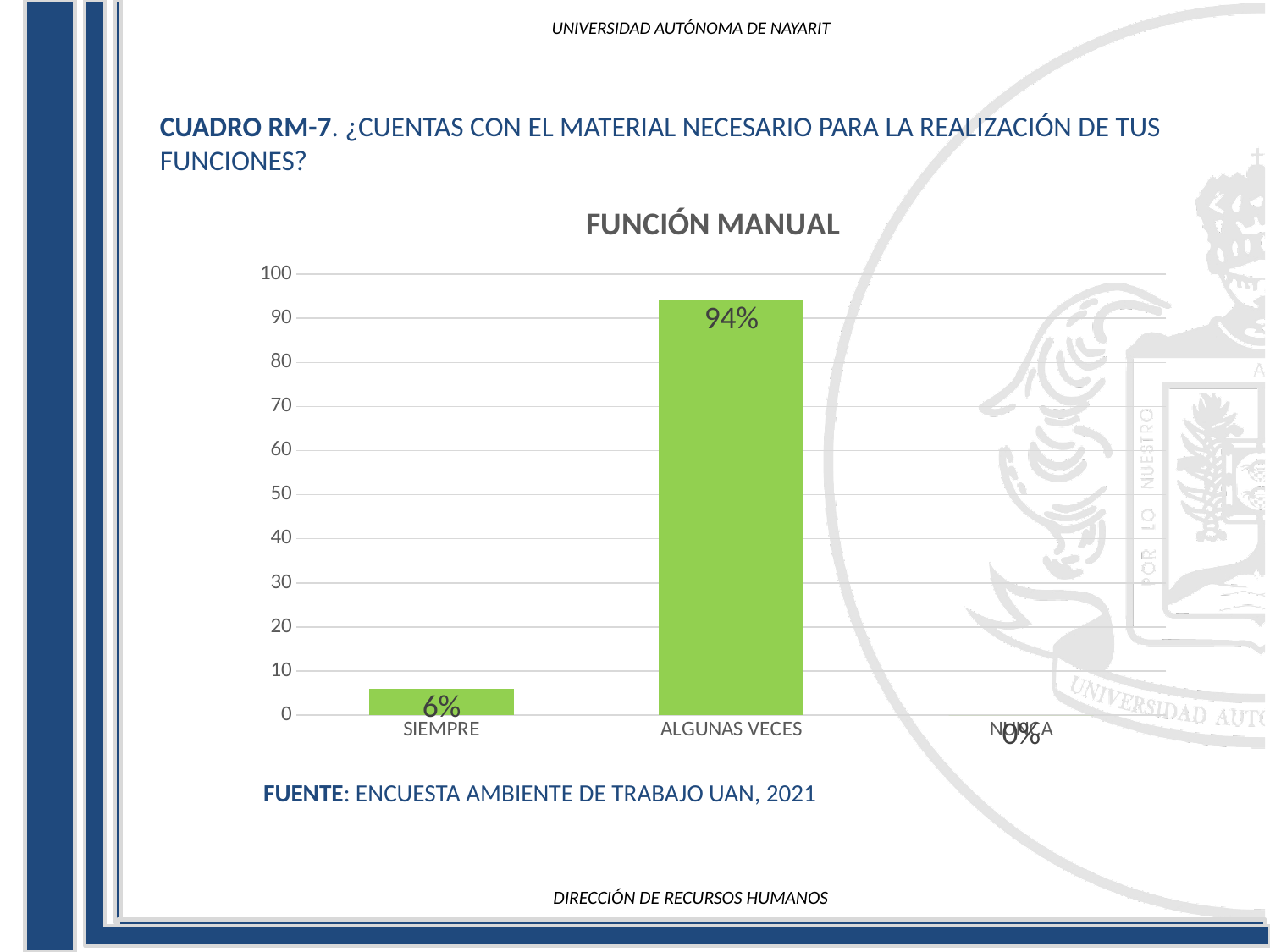
Which category has the lowest value? NUNCA What is the value for SIEMPRE? 6% What is the value for NUNCA? 0% Which is larger, the value for SIEMPRE or the value for ALGUNAS VECES? ALGUNAS VECES What is the value for ALGUNAS VECES? 94% Is the value for SIEMPRE greater or less than 10? less What kind of chart is shown? bar chart What is the title of the chart? FUNCIÓN MANUAL How many categories are shown on the x axis? 3 Is the value for ALGUNAS VECES greater or less than 90? greater Which category has the highest value? ALGUNAS VECES What is the difference between the values for ALGUNAS VECES and SIEMPRE? 88%